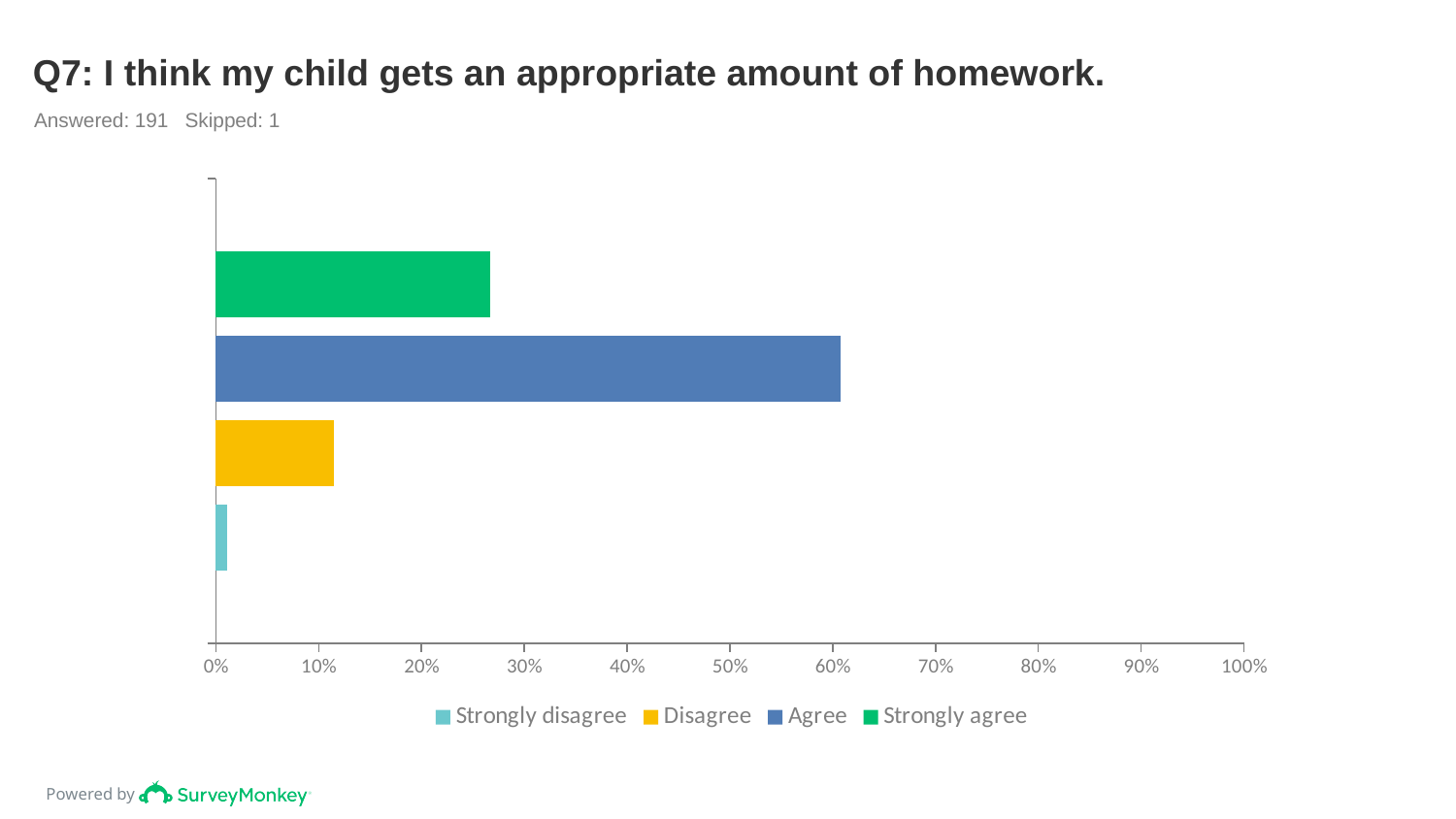
Which response category has the highest value? Agree How many bars are plotted in the chart? 4 Is the value for Strongly agree greater or less than 30%? less What kind of chart is shown on the slide? bar chart Is the value for Strongly disagree greater or less than 10%? less Which response category has the lowest value? Strongly disagree Is the value for Disagree greater or less than 10%? greater Which is larger, the value for Strongly agree or the value for Disagree? Strongly agree Which is larger, the value for Agree or the value for Strongly agree? Agree How many entries does the legend list? 4 How many respondents answered this question according to the slide? 191